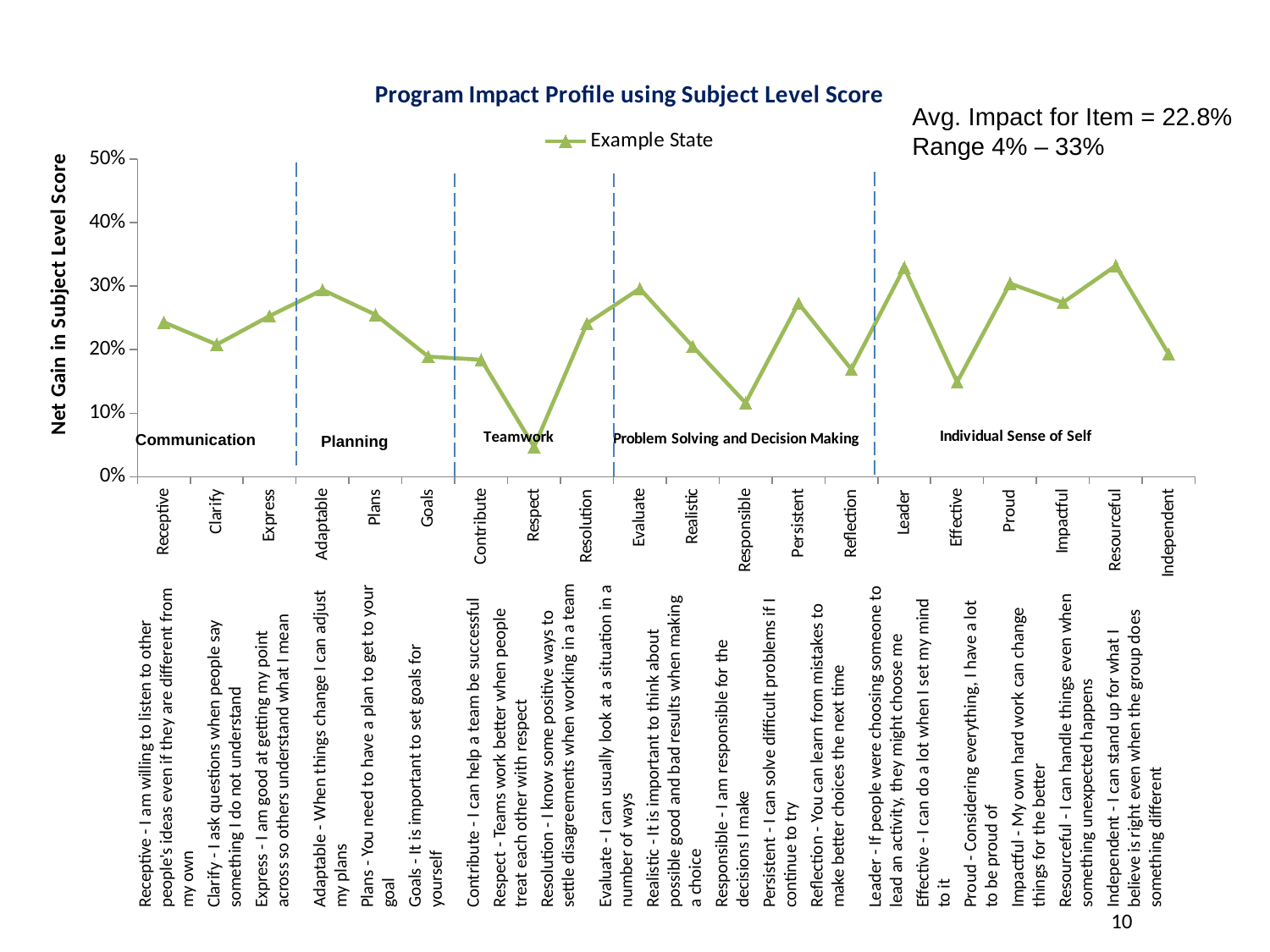
Is the value for Adaptable greater or less than 20%? greater Is the value for Leader greater or less than 30%? greater Is the value for Respect greater or less than 10%? less How many series does the legend list? 1 Which is larger, the value for Respect or the value for Leader? Leader What is the title of the chart? Program Impact Profile using Subject Level Score Which is larger, the value for Responsible or the value for Persistent? Persistent Which item has the lowest net gain in subject level score? Respect How many items (categories) are plotted along the x axis? 20 What kind of chart is shown on the slide? line chart